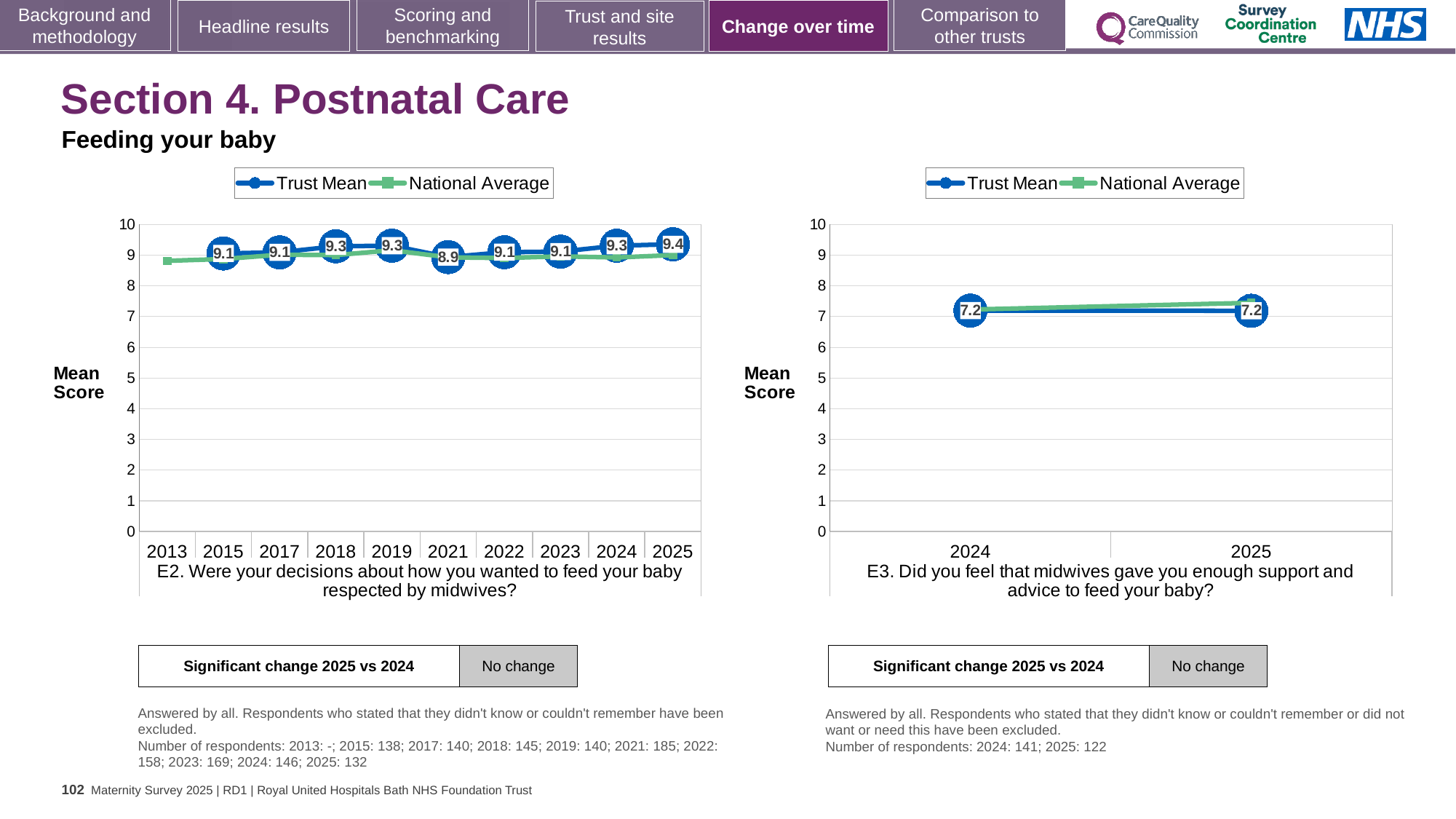
How many series does the legend of the right chart (E3) list? 2 In the left chart (E2), which year has the highest Trust Mean? 2025 In the right chart (E3), is the National Average for 2025 greater or less than 7? greater In the left chart (E2), what is the Trust Mean for 2021? 8.9 In the left chart (E2), what is the Trust Mean for 2025? 9.4 What kind of chart is the left chart (E2)? Line chart In the right chart (E3), what is the Trust Mean for 2024? 7.2 In the left chart (E2), what is the difference between the Trust Mean for 2025 and 2024? 0.1 What are the two series named in the legend of the left chart (E2)? Trust Mean and National Average How many years are shown on the x axis of the left chart (E2)? 10 In the left chart (E2), is the Trust Mean higher in 2019 or in 2021? 2019 In the left chart (E2), which year has the lowest labelled Trust Mean? 2021